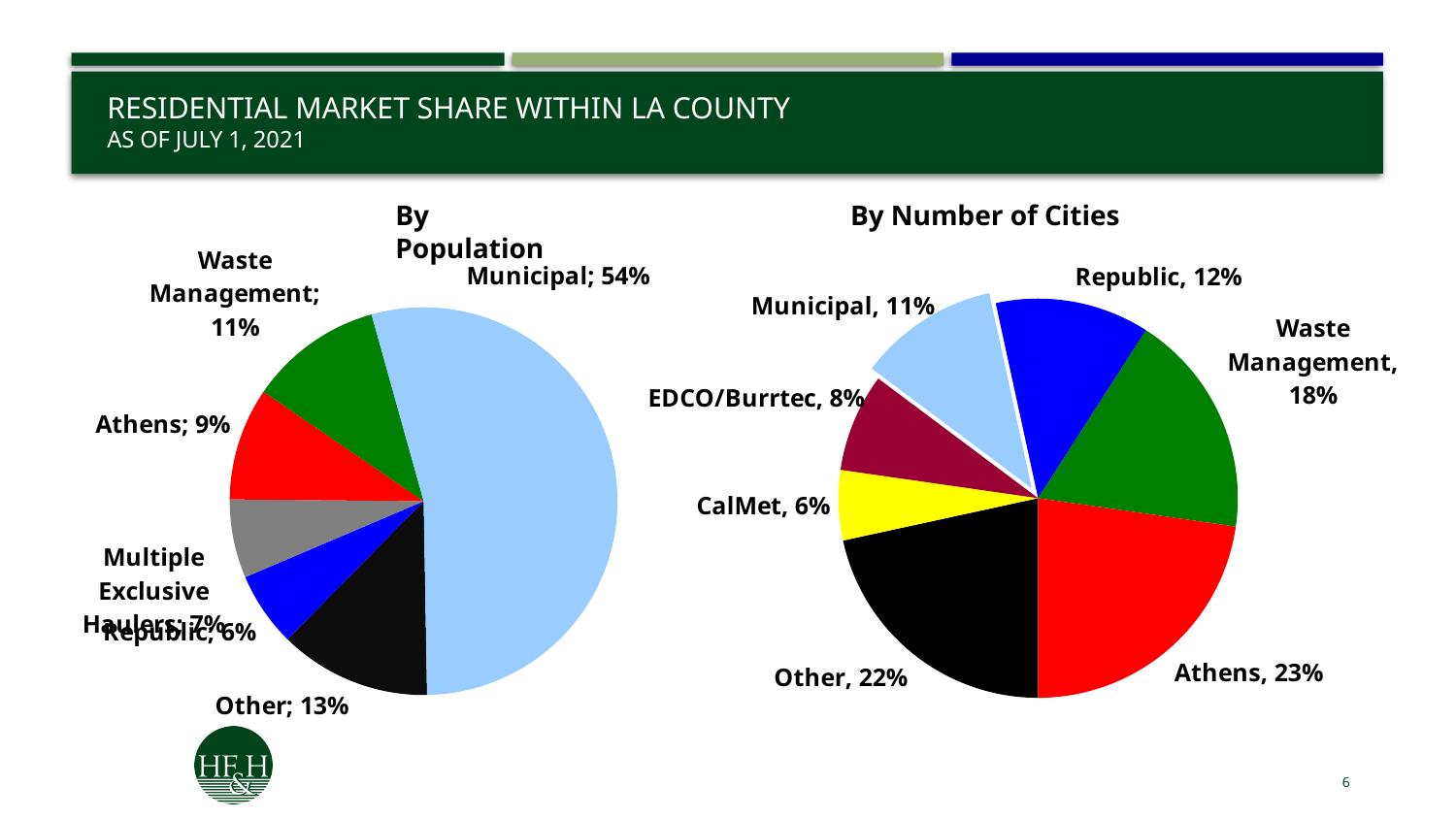
In the 'By Number of Cities' chart, which is larger, the Waste Management share or the Republic share? Waste Management In the 'By Population' chart, which category has the largest slice? Municipal In the 'By Number of Cities' chart, what share does Athens hold? 23% In the 'By Number of Cities' chart, which category has the largest slice? Athens In the 'By Population' chart, what share does Municipal hold? 54% In the 'By Number of Cities' chart, what share does EDCO/Burrtec hold? 8% How many slices does the 'By Population' chart have? 6 In the 'By Number of Cities' chart, which category has the smallest slice? CalMet In the 'By Population' chart, what share does Waste Management hold? 11% In the 'By Population' chart, what is the difference between the Municipal share and the Other share? 41% What type of chart is the 'By Population' chart? Pie chart How many slices does the 'By Number of Cities' chart have? 7